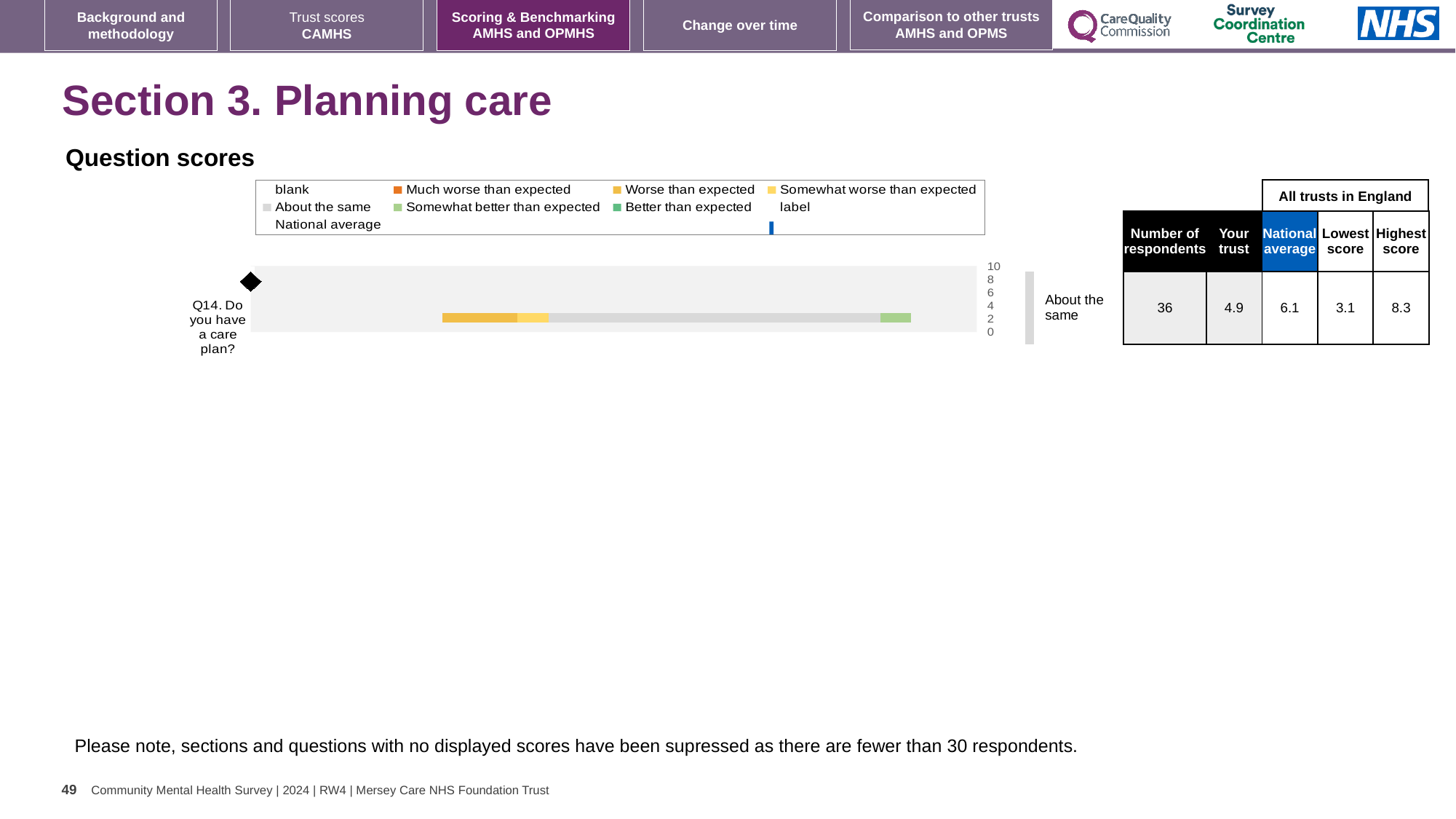
What is the lowest score among all trusts in England for Q14? 3.1 What kind of chart is used to show the question scores on this slide? bar chart What is the highest score among all trusts in England for Q14? 8.3 What benchmark category is shown next to the bar for Q14? About the same Which is larger for Q14, the trust's score or the national average? national average Which question is plotted in the question scores chart? Q14. Do you have a care plan? How many questions are plotted in the question scores chart? 1 How many respondents answered Q14. Do you have a care plan? 36 What is the national average score for Q14. Do you have a care plan? 6.1 What is the maximum value shown on the score axis of the question scores chart? 10 What is the 'Your trust' score for Q14. Do you have a care plan? 4.9 What is the difference between the highest score and the lowest score for Q14? 5.2